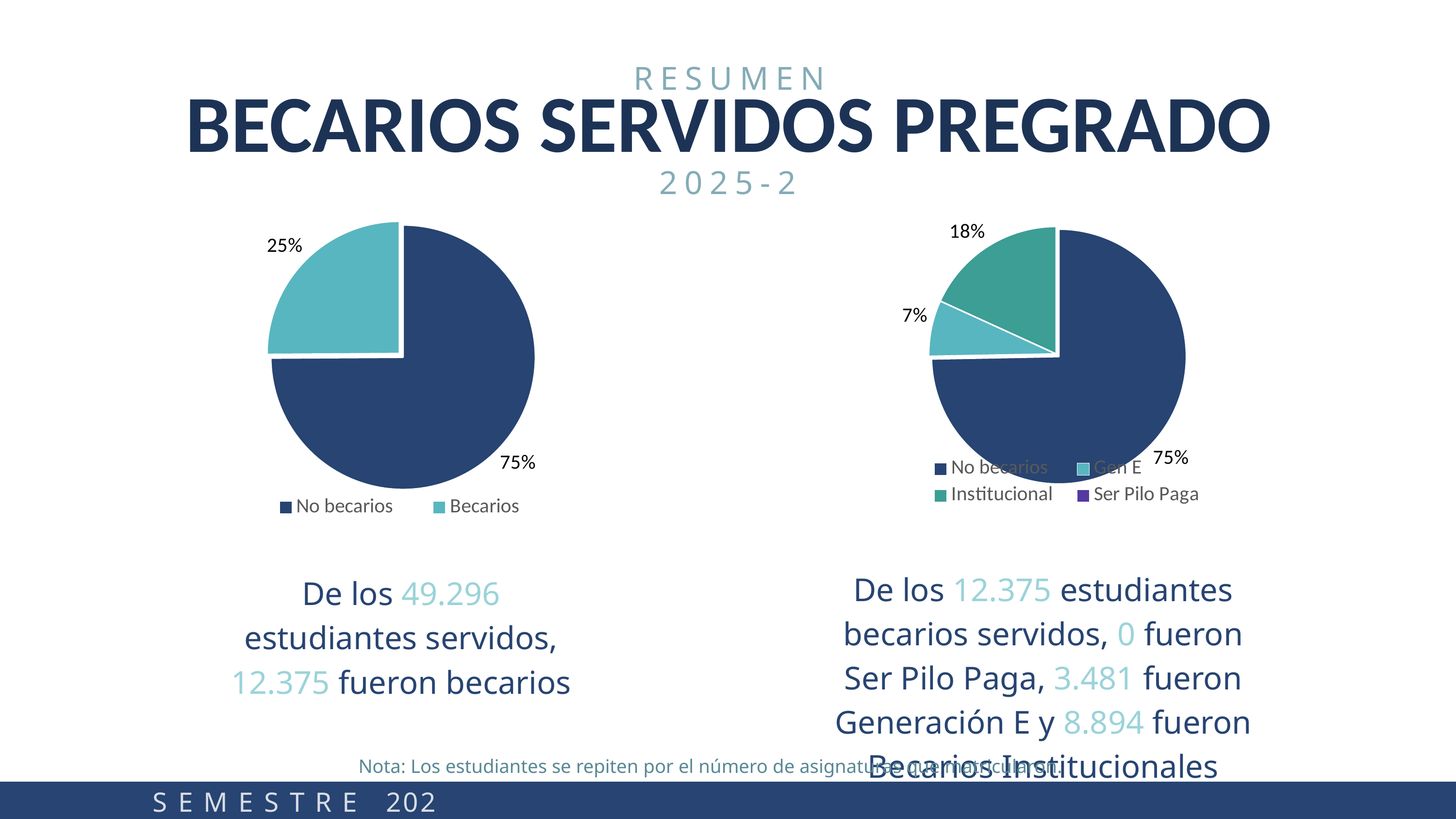
What kind of chart is the chart on the left of the slide? pie chart In the right pie chart, which is larger, the Institucional slice or the Gen E slice? Institucional In the right pie chart, what share of the pie is labelled Institucional? 18% In the right pie chart, what is the difference in percentage points between the Institucional slice and the Gen E slice? 11% In the right pie chart, what share of the pie is labelled Gen E? 7% In the right pie chart, which legend entry is shown in purple? Ser Pilo Paga How many entries does the legend of the right pie chart list? 4 In the right pie chart, which slice is the smallest among the visible slices? Gen E In the left pie chart, which slice is the largest? No becarios In the left pie chart, what share of the pie is labelled No becarios? 75% How many entries does the legend of the left pie chart list? 2